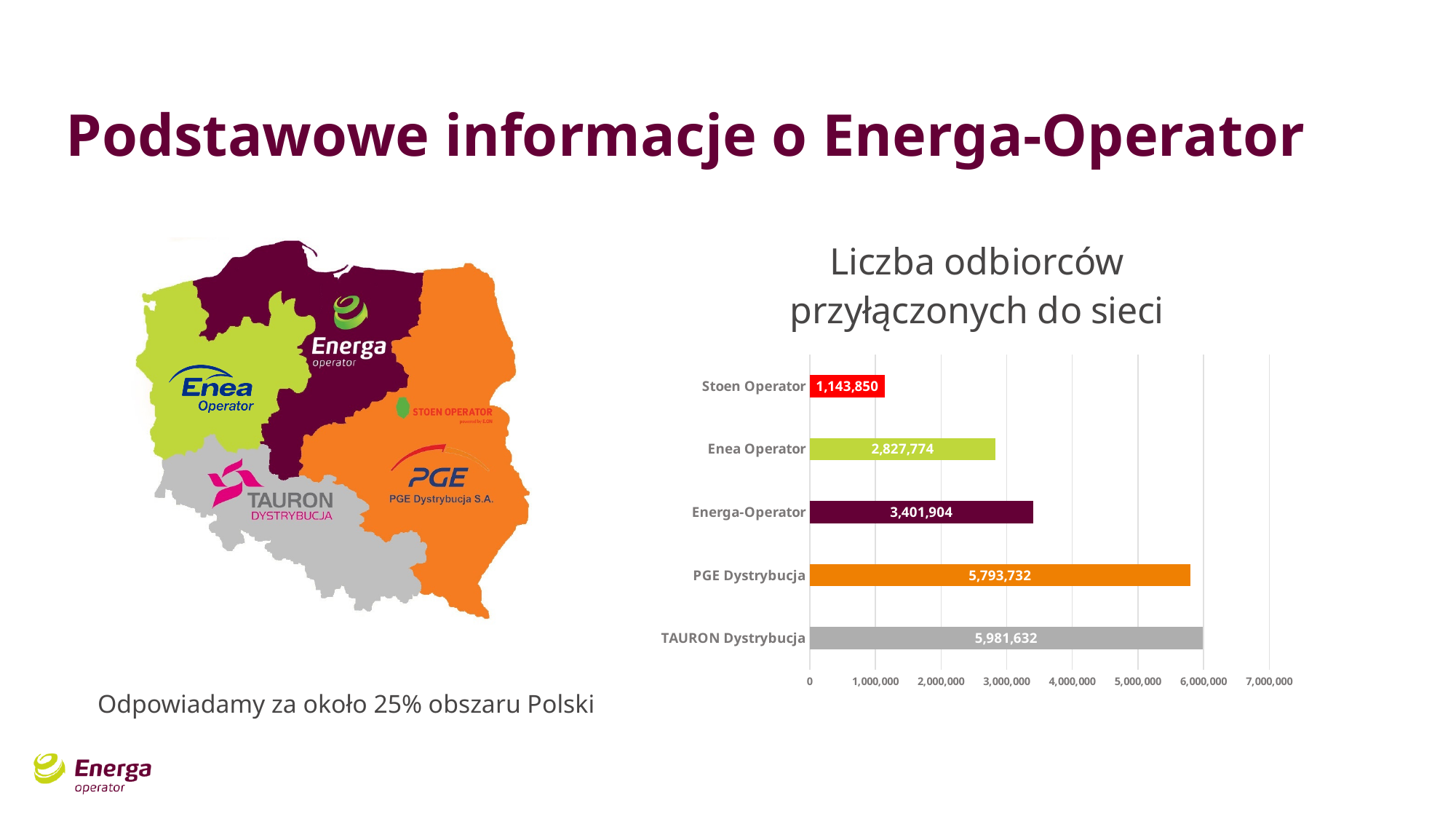
How many categories are shown in the chart? 5 What is the value for Energa-Operator in the chart? 3,401,904 Which is larger, the value for Energa-Operator or the value for Enea Operator? Energa-Operator What is the value for Enea Operator in the chart? 2,827,774 Is the value for Energa-Operator greater or less than 3,000,000? greater Which category has the highest value in the chart? TAURON Dystrybucja Which category has the lowest value in the chart? Stoen Operator What kind of chart is shown on the slide? bar chart What is the difference between the values for Energa-Operator and Enea Operator? 574,130 What is the difference between the values for TAURON Dystrybucja and PGE Dystrybucja? 187,900 What is the value for PGE Dystrybucja in the chart? 5,793,732 What is the value for Stoen Operator in the chart? 1,143,850